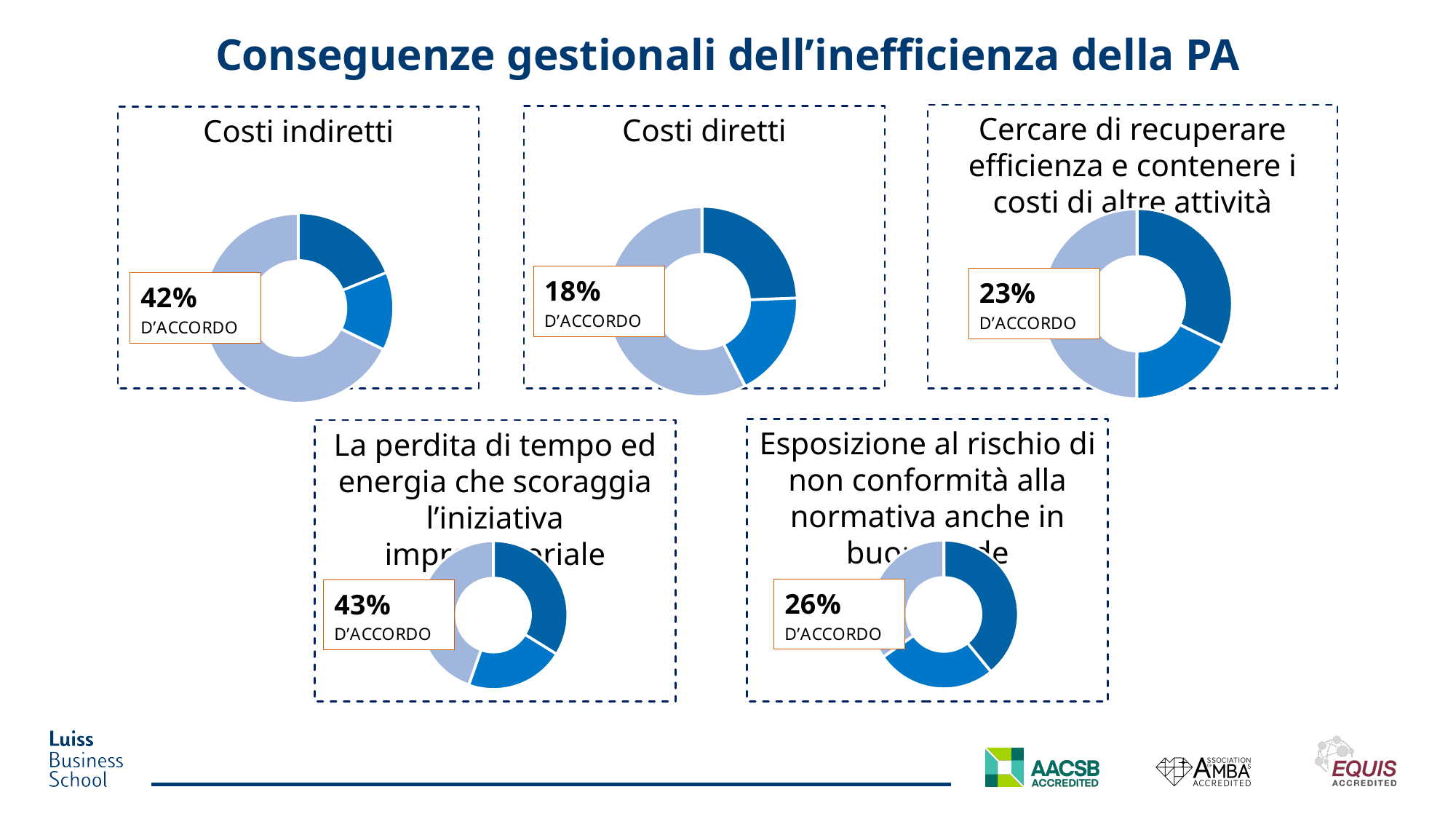
On the 'La perdita di tempo ed energia che scoraggia l'iniziativa imprenditoriale' chart, what percentage is shown as 'D'ACCORDO'? 43% On the 'Esposizione al rischio di non conformità alla normativa anche in buona fede' chart, what percentage is shown as 'D'ACCORDO'? 26% Which chart on the slide shows the lowest 'D'ACCORDO' percentage? Costi diretti On the 'Costi indiretti' chart, what percentage is shown as 'D'ACCORDO'? 42% How many charts are shown on the slide? 5 What type of chart is used for 'Costi indiretti'? Donut (pie) chart On the 'Costi diretti' chart, what percentage is shown as 'D'ACCORDO'? 18% What is the title of the slide? Conseguenze gestionali dell'inefficienza della PA Which has a higher 'D'ACCORDO' percentage: the 'Costi diretti' chart or the 'Esposizione al rischio di non conformità' chart? Esposizione al rischio di non conformità What is the difference between the 'D'ACCORDO' percentage on the 'Costi indiretti' chart and the one on the 'Costi diretti' chart? 24% Which chart on the slide shows the highest 'D'ACCORDO' percentage? La perdita di tempo ed energia che scoraggia l'iniziativa imprenditoriale On the 'Cercare di recuperare efficienza e contenere i costi di altre attività' chart, what percentage is shown as 'D'ACCORDO'? 23%